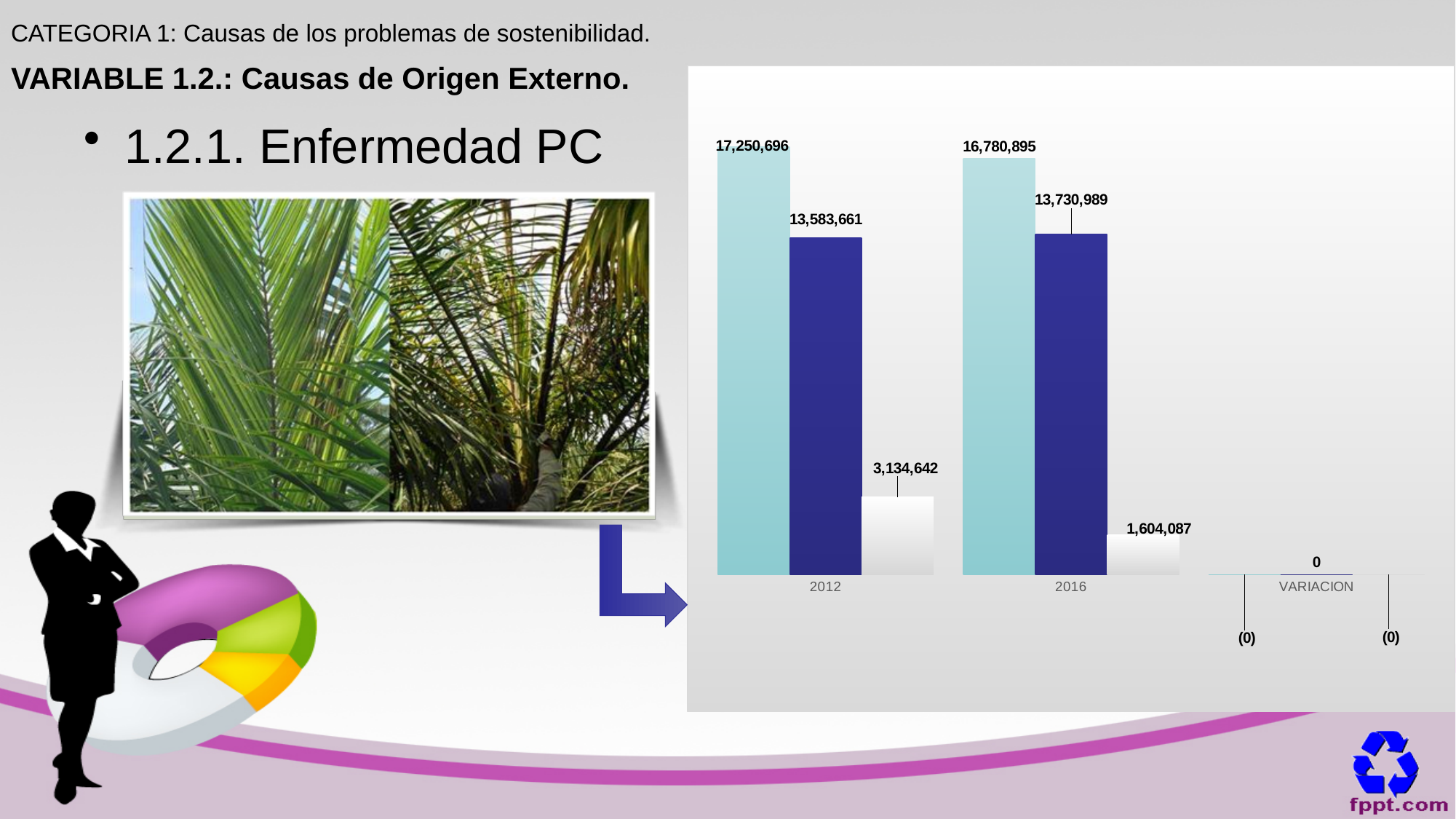
What is the value of the light blue bar for 2016? 16,780,895 What is the label of the third category on the x axis? VARIACION What is the difference between the light blue bar values for 2012 and 2016? 469,801 What is the value of the light blue bar for 2012? 17,250,696 How many categories are shown on the x axis of the chart? 3 What type of chart is shown on the slide? bar chart What is the difference between the white bar values for 2012 and 2016? 1,530,555 What is the value of the white bar for 2012? 3,134,642 Which category has the highest light blue bar? 2012 Which is larger, the dark blue bar for 2012 or the dark blue bar for 2016? 2016 What is the value of the white bar for 2016? 1,604,087 What is the value of the dark blue bar for 2016? 13,730,989